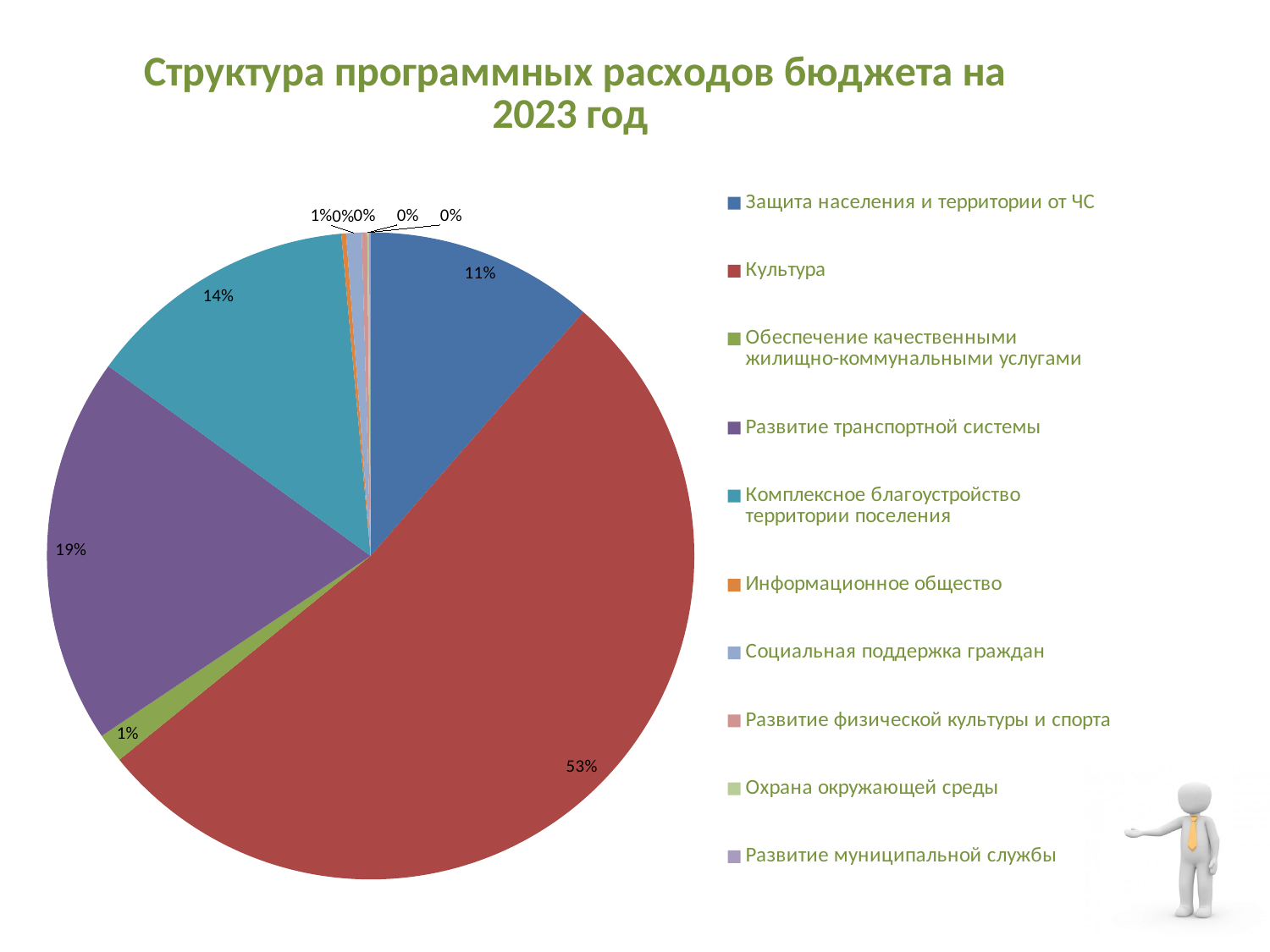
What share of the pie does «Развитие транспортной системы» take? 19% What is the title of the chart? Структура программных расходов бюджета на 2023 год What share of the pie does «Обеспечение качественными жилищно-коммунальными услугами» take? 1% What share of the pie does «Комплексное благоустройство территории поселения» take? 14% Which slice is larger: «Защита населения и территории от ЧС» or «Комплексное благоустройство территории поселения»? Комплексное благоустройство территории поселения How many categories does the legend list? 10 What kind of chart is shown on the slide? pie chart Which slice is larger: «Развитие транспортной системы» or «Комплексное благоустройство территории поселения»? Развитие транспортной системы Which category has the largest slice of the pie? Культура By how many percentage points does the «Культура» share exceed the «Защита населения и территории от ЧС» share? 42 percentage points